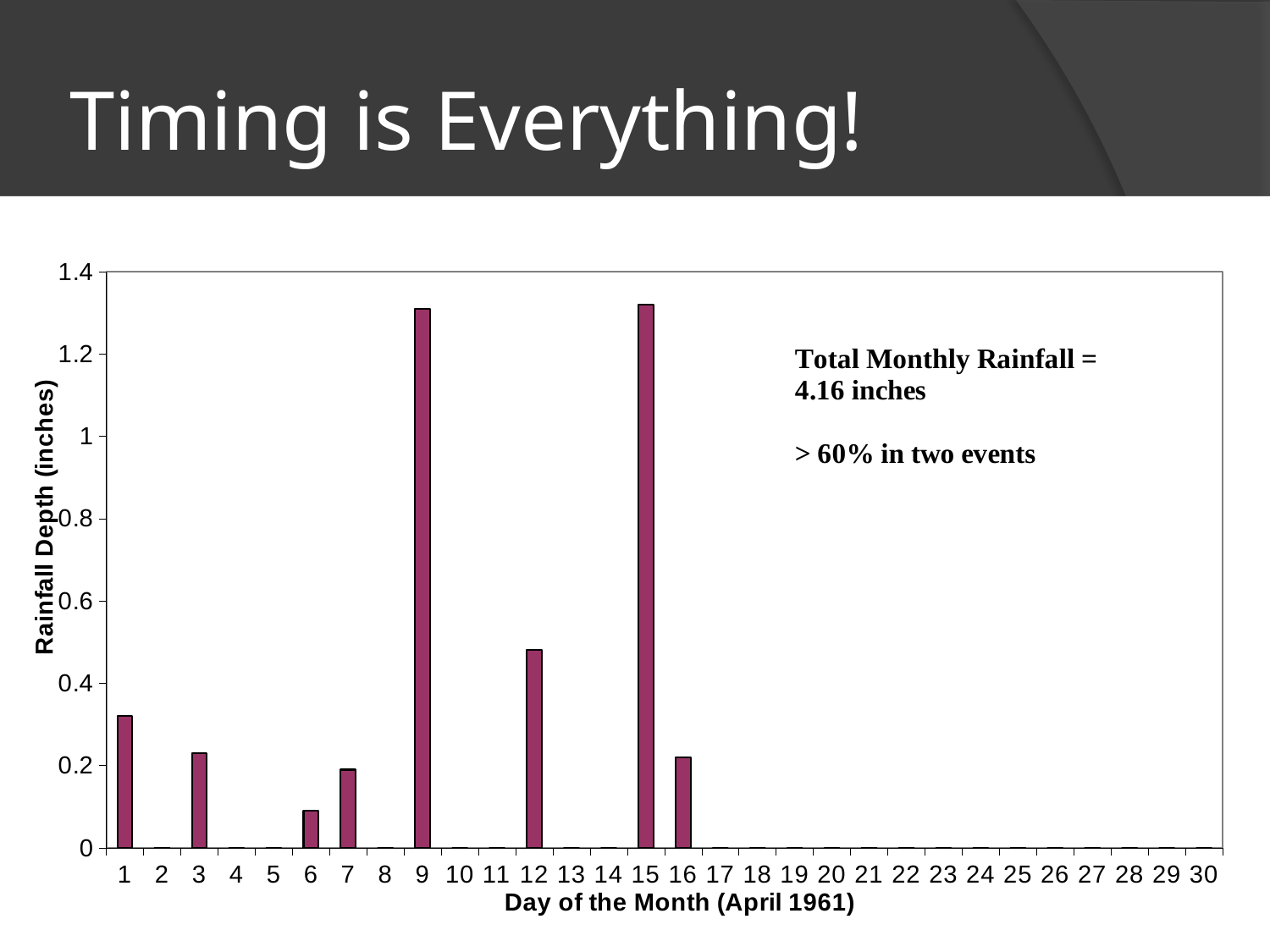
How many days show a non-zero rainfall bar? 8 How many days of the month are shown along the x axis? 30 Is the rainfall depth for day 15 greater or less than 1 inch? greater Among the days with rainfall, which day has the lowest rainfall depth? day 6 What is the label of the y axis? Rainfall Depth (inches) Is the rainfall depth for day 9 greater or less than 1.2 inches? greater Is the rainfall depth for day 12 greater or less than 0.4 inches? greater What kind of chart is shown on the slide? bar chart Which day has more rainfall, day 1 or day 3? day 1 Which day has more rainfall, day 9 or day 12? day 9